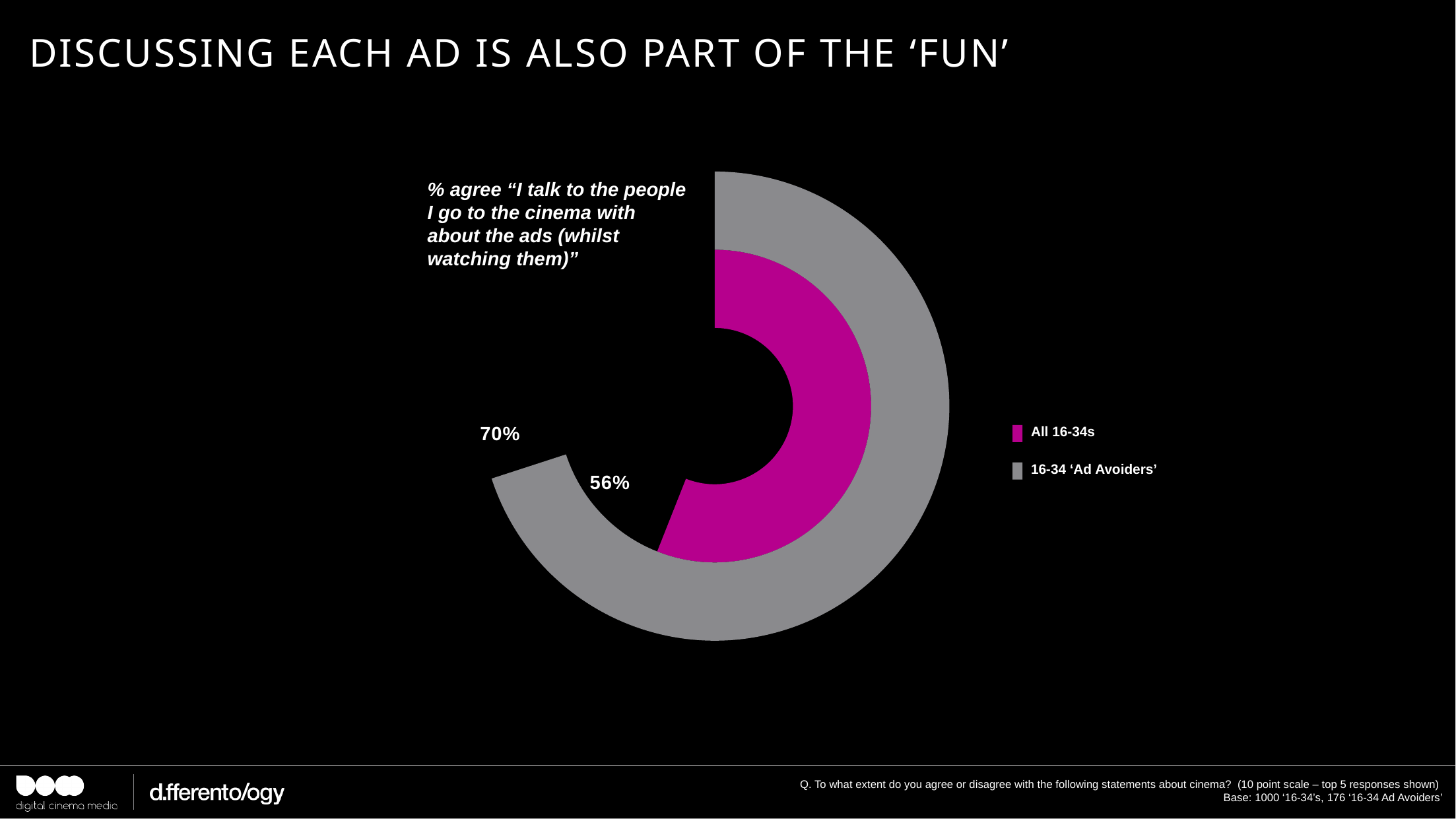
Is the value for 16-34 'Ad Avoiders' greater or less than 60%? greater What kind of chart is shown on the slide? Doughnut chart Is the value for All 16-34s greater or less than 50%? greater Which group has the higher percentage agreeing with the statement, All 16-34s or 16-34 'Ad Avoiders'? 16-34 'Ad Avoiders' What is the difference in percentage points between 16-34 'Ad Avoiders' and All 16-34s? 14 percentage points Is the value for All 16-34s larger or smaller than the value for 16-34 'Ad Avoiders'? smaller Which colour represents All 16-34s in the chart? Magenta What percentage of 16-34 'Ad Avoiders' agree with the statement "I talk to the people I go to the cinema with about the ads (whilst watching them)"? 70% Which group has the lower percentage agreeing with the statement? All 16-34s What percentage of All 16-34s agree with the statement "I talk to the people I go to the cinema with about the ads (whilst watching them)"? 56% How many groups does the legend list? 2 Which colour represents 16-34 'Ad Avoiders' in the chart? Grey